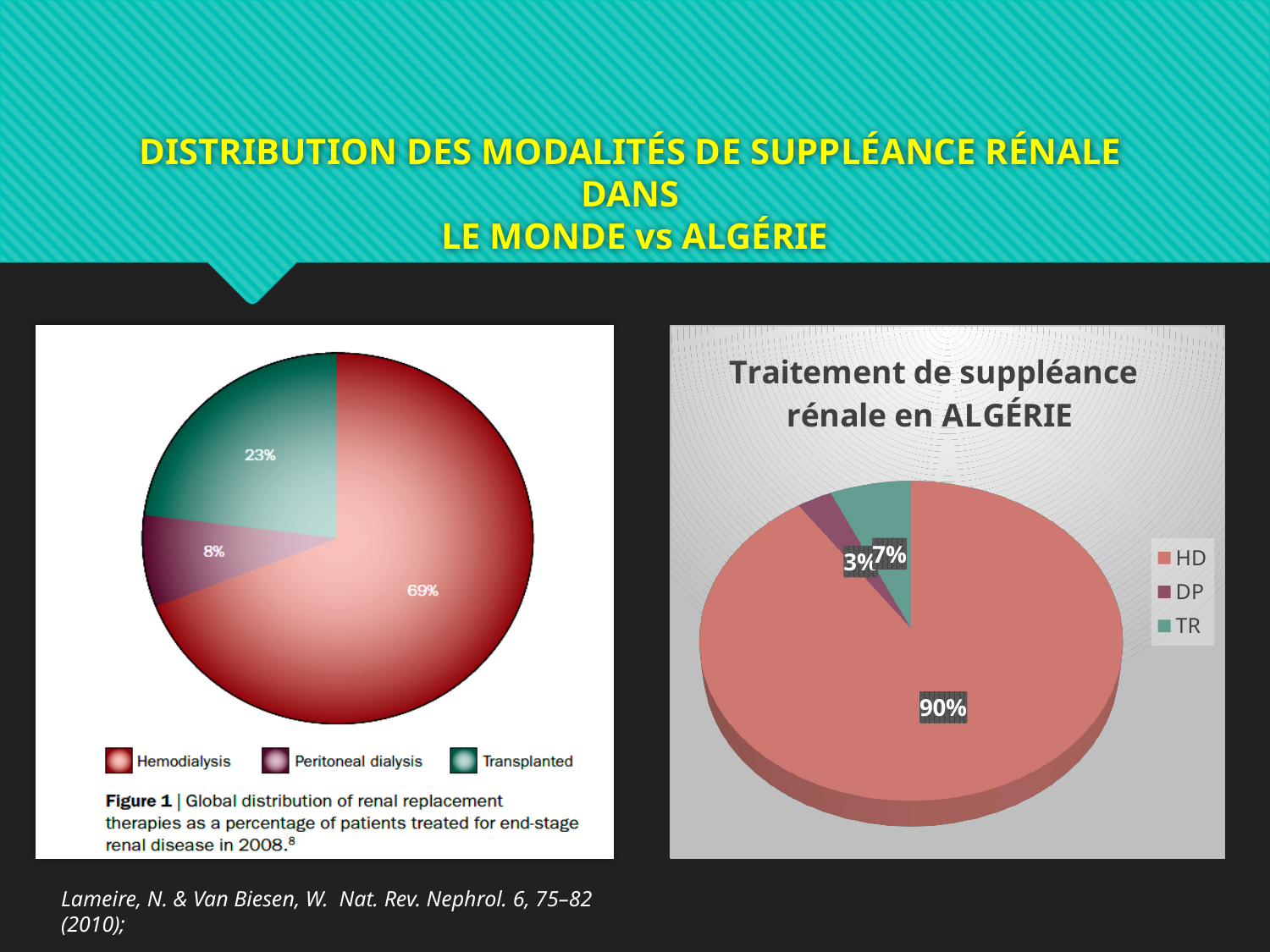
In the left chart (Global distribution of renal replacement therapies), what percentage is shown for Transplanted? 23% In the right chart (Traitement de suppléance rénale en ALGÉRIE), what percentage is shown for TR? 7% In the right chart (Traitement de suppléance rénale en ALGÉRIE), which category has the smallest slice? DP Which is larger: the Transplanted share in the left chart or the TR share in the right chart? Transplanted share in the left chart In the right chart (Traitement de suppléance rénale en ALGÉRIE), what percentage is shown for HD? 90% In the left chart (Global distribution of renal replacement therapies), what percentage is shown for Peritoneal dialysis? 8% What type of chart is the right chart (Traitement de suppléance rénale en ALGÉRIE)? Pie chart In the left chart (Global distribution of renal replacement therapies), which category has the largest slice? Hemodialysis How many categories does the legend of the right chart (Traitement de suppléance rénale en ALGÉRIE) list? 3 In the left chart (Global distribution of renal replacement therapies), what percentage is shown for Hemodialysis? 69% What is the difference between the Hemodialysis share in the left chart and the HD share in the right chart? 21 percentage points In the left chart (Global distribution of renal replacement therapies), what is the difference between the Transplanted and Peritoneal dialysis shares? 15 percentage points